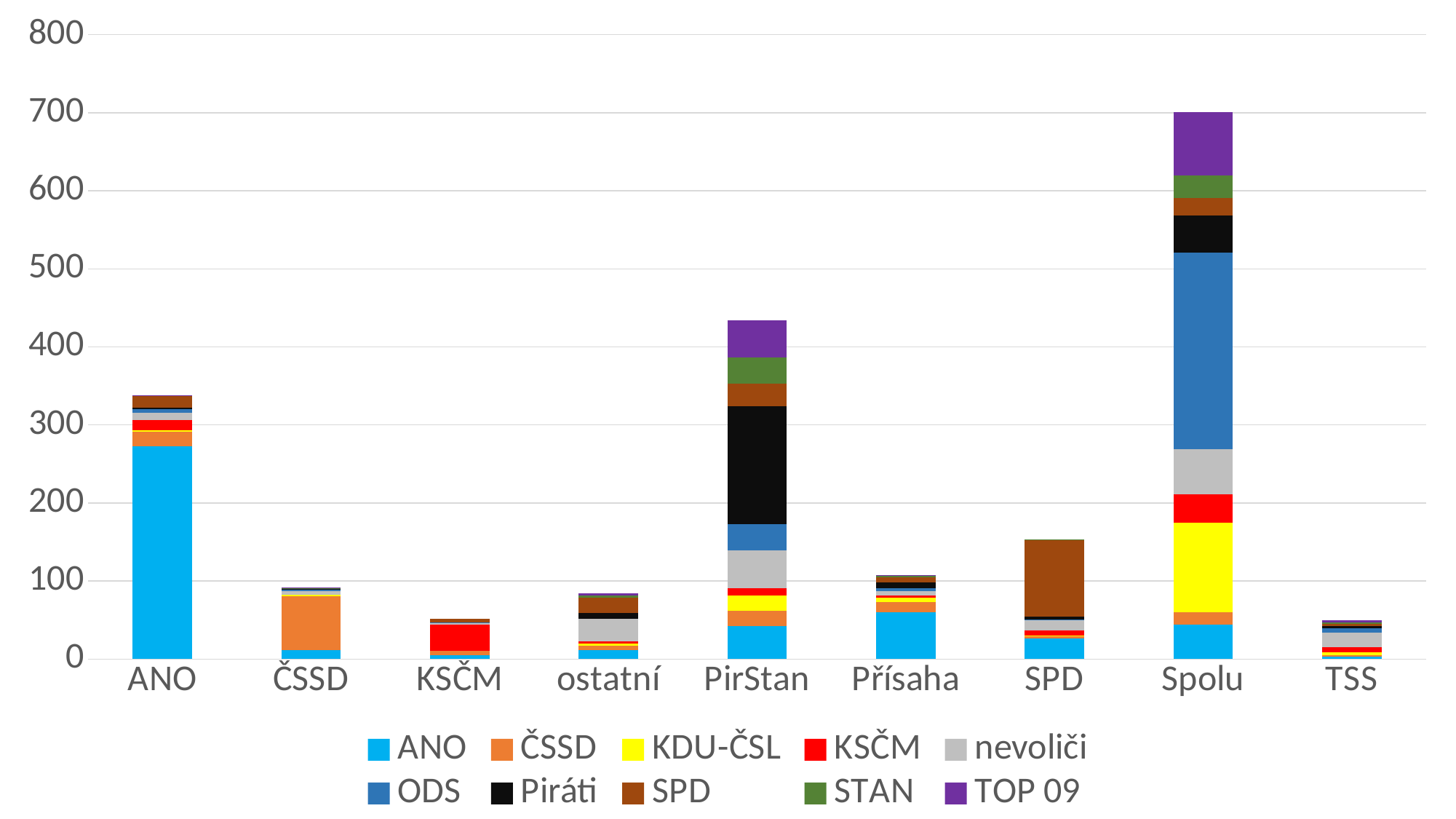
Is the total value for ANO greater or less than 300? greater Which has the larger total bar, Spolu or PirStan? Spolu What kind of chart is shown on the slide? stacked bar chart Is the total value for Spolu greater or less than 600? greater Which category has the tallest stacked bar? Spolu Is the total value for ČSSD greater or less than 100? less How many series does the legend list? 10 How many categories are shown on the x axis? 9 Which has the larger total bar, ANO or SPD? ANO What colour represents the Piráti series in the legend? black